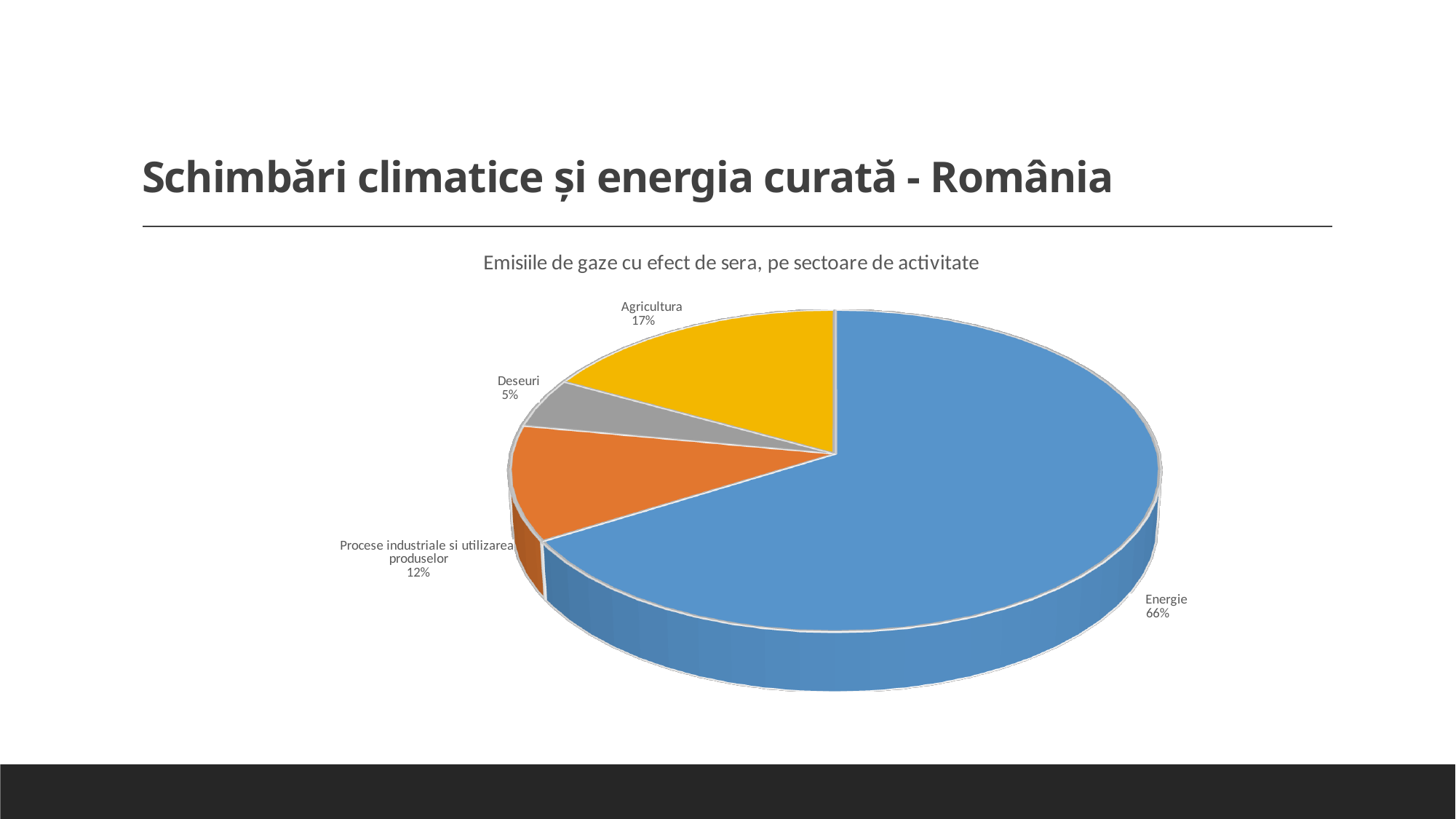
What is the title of the chart? Emisiile de gaze cu efect de sera, pe sectoare de activitate What share of the pie does Energie account for? 66% Which sector has the smallest share of emissions? Deseuri What share of the pie does Procese industriale si utilizarea produselor account for? 12% What is the difference in percentage points between the Agricultura and Deseuri shares? 12 What share of the pie does Agricultura account for? 17% Which has a larger share, Agricultura or Procese industriale si utilizarea produselor? Agricultura How many sectors are shown in the pie chart? 4 What kind of chart is shown on the slide? Pie chart What is the difference in percentage points between the Energie and Agricultura shares? 49 Which sector has the largest share of emissions? Energie